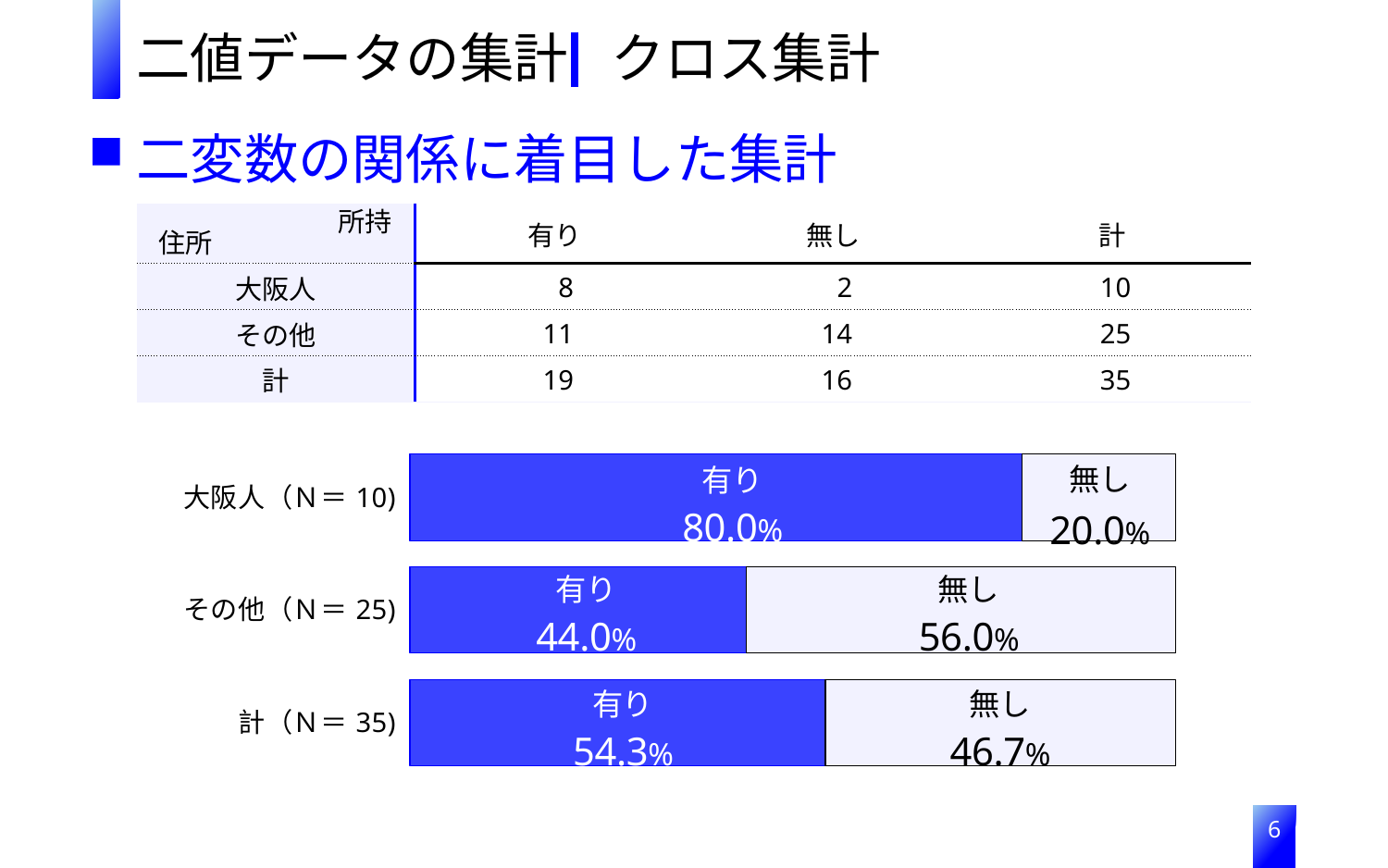
In the bar chart, what is the 無し percentage for その他 (N＝25)? 56.0% Which group has the highest 有り percentage in the bar chart? 大阪人 (N＝10) What is the difference between the 有り percentage for 大阪人 (N＝10) and for その他 (N＝25)? 36.0% In the bar chart, what is the 無し percentage for 大阪人 (N＝10)? 20.0% What colour is the 有り segment in the bar chart? blue In the bar chart, what is the 有り percentage for 大阪人 (N＝10)? 80.0% In the bar chart, what is the 有り percentage for 計 (N＝35)? 54.3% How many segments does each bar in the chart have? 2 Which group has the lowest 有り percentage in the bar chart? その他 (N＝25) How many bars are shown in the bar chart? 3 What kind of chart is shown on the slide? stacked bar chart For その他 (N＝25), which is larger: 有り or 無し? 無し